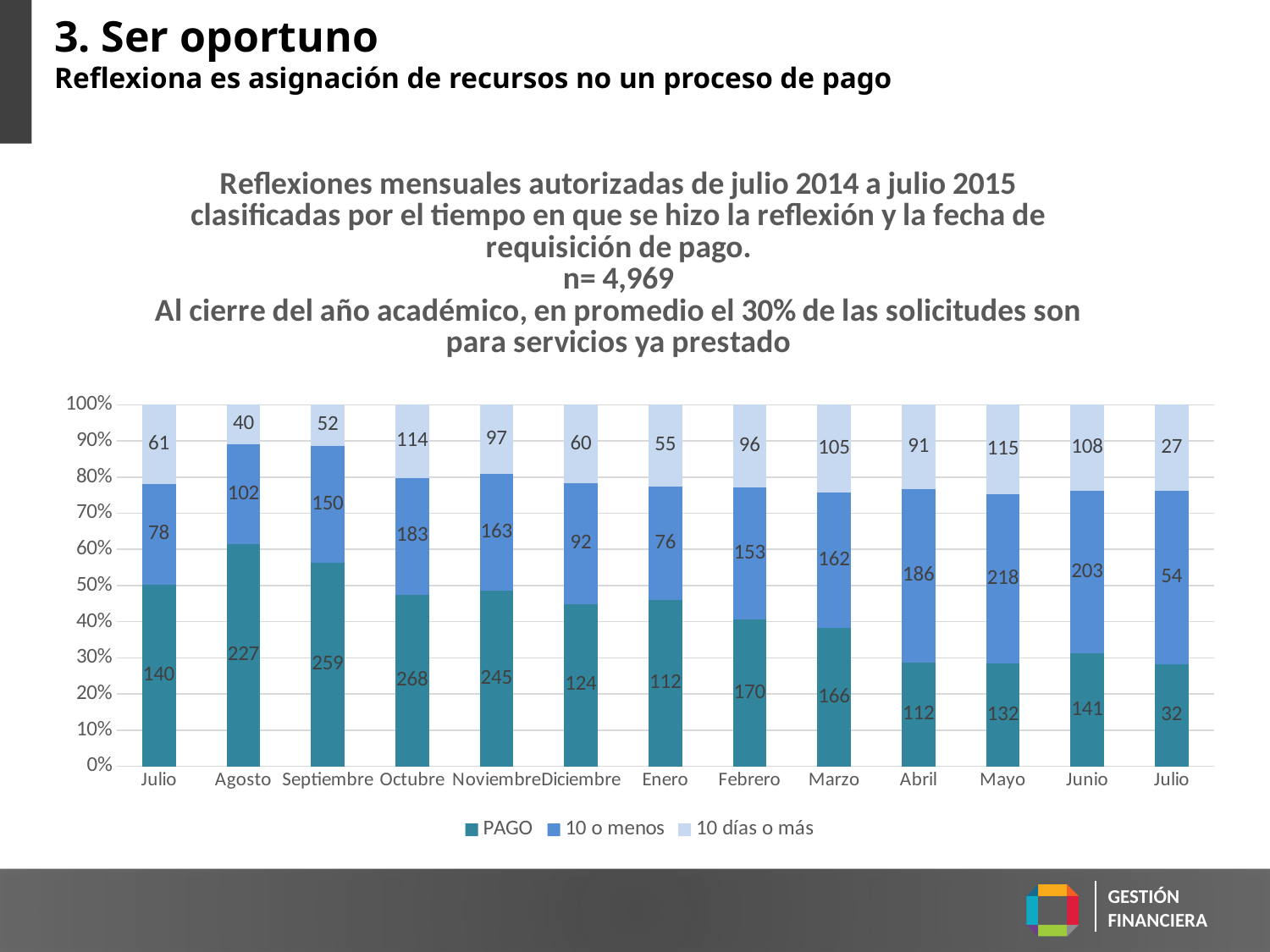
What is the sample size (n) stated in the chart title? 4,969 Which is larger, the '10 o menos' value for Abril or for Febrero? Abril What is the total of the three values in the Agosto bar? 369 Which month has the highest PAGO value? Octubre Which month has the lowest '10 días o más' value? Julio (the last bar, 2015) How many months (categories) are shown on the x axis? 13 How many series does the legend list? 3 What is the PAGO value for Octubre? 268 What is the difference between the PAGO values for Septiembre and Diciembre? 135 What type of chart is shown on the slide? stacked bar chart What is the '10 días o más' value for Marzo? 105 What is the '10 o menos' value for Mayo? 218